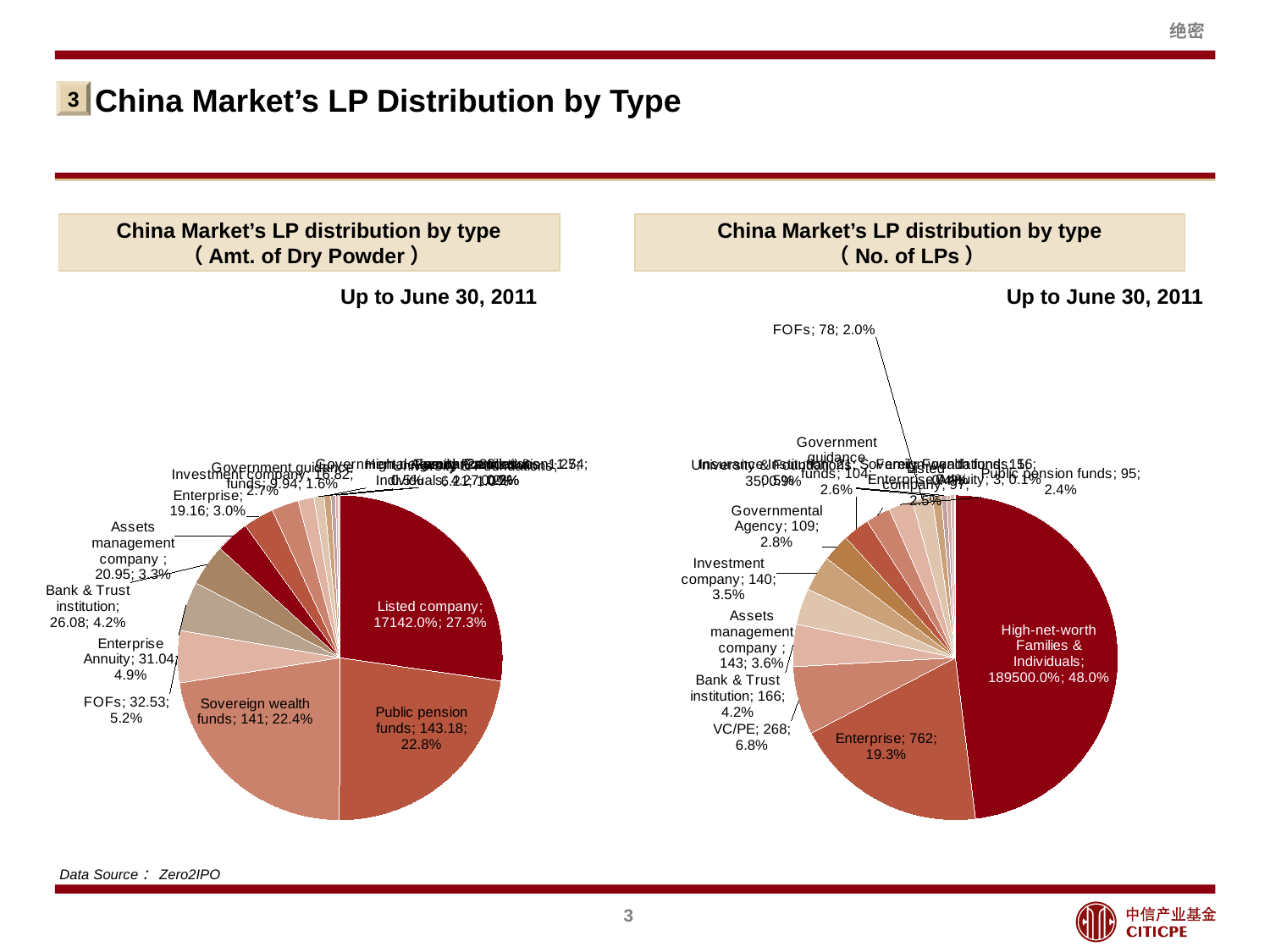
In the 'Amt. of Dry Powder' chart, what is the difference between the values for FOFs and Bank & Trust institution? 6.45 In the 'Amt. of Dry Powder' chart, what share does Listed company hold? 27.3% In the 'No. of LPs' chart, what is the number of LPs for VC/PE? 268 What date are both charts reported up to? June 30, 2011 In the 'No. of LPs' chart, what is the number of LPs for Enterprise? 762 In the 'No. of LPs' chart, what is the difference between the number of LPs for Bank & Trust institution and Investment company? 26 In the 'Amt. of Dry Powder' chart, what is the value for Sovereign wealth funds? 141 In the 'Amt. of Dry Powder' chart, which category has the largest share? Listed company In the 'Amt. of Dry Powder' chart, what is the value for Public pension funds? 143.18 In the 'No. of LPs' chart, what share does High-net-worth Families & Individuals hold? 48.0% In the 'Amt. of Dry Powder' chart, which is larger, FOFs or Enterprise Annuity? FOFs What type of chart is used on this slide? Pie chart